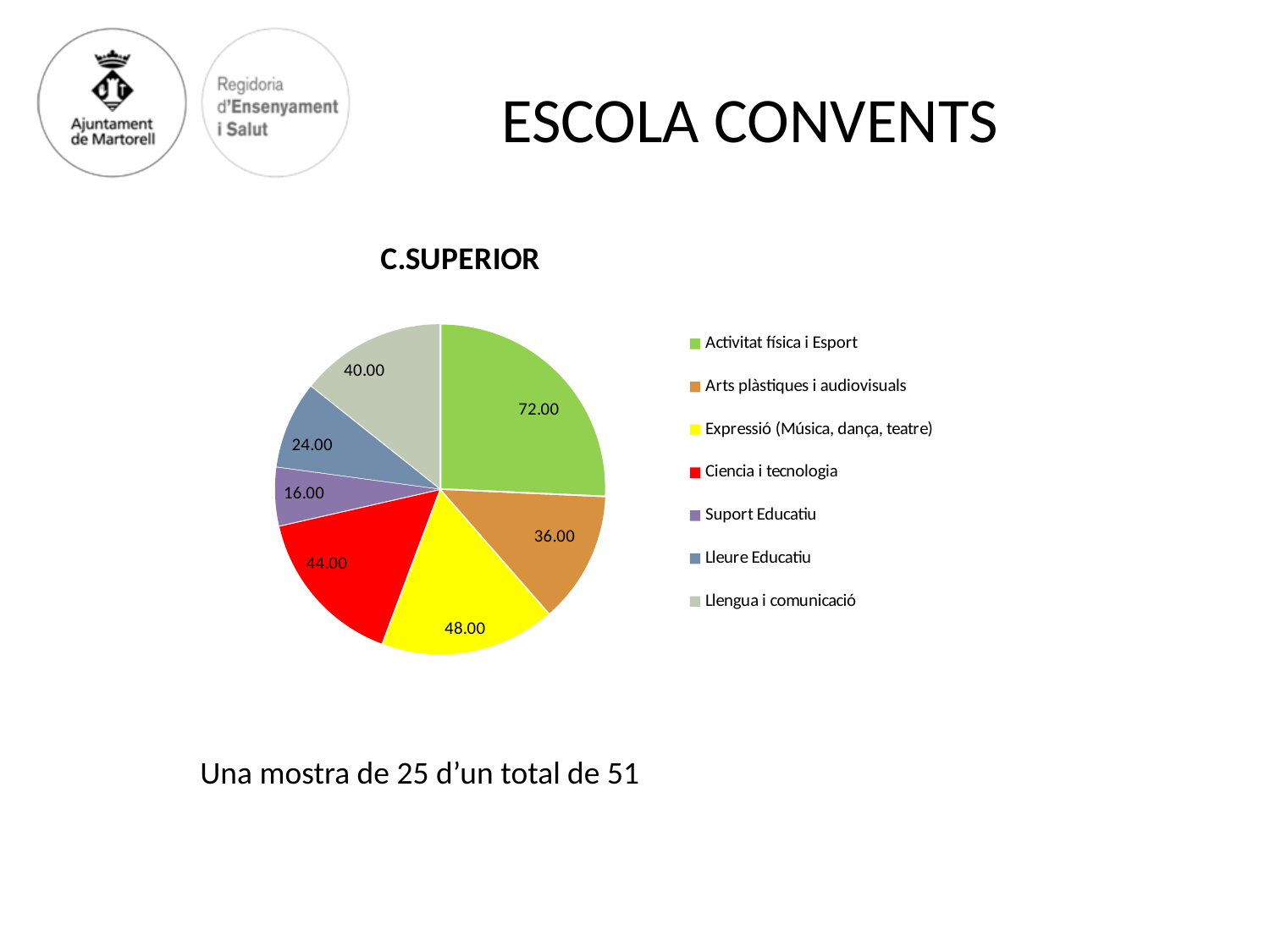
What is the difference between the values for Expressió (Música, dança, teatre) and Arts plàstiques i audiovisuals? 12.00 Which is larger, the value for Lleure Educatiu or the value for Llengua i comunicació? Llengua i comunicació What is the value for Suport Educatiu? 16.00 What is the value for Ciencia i tecnologia? 44.00 What is the title of the chart? C.SUPERIOR Which category has the largest slice of the pie? Activitat física i Esport Which category has the smallest slice of the pie? Suport Educatiu What colour is the slice for Ciencia i tecnologia? red What type of chart is shown on the slide? pie chart How many categories does the legend list? 7 What is the value for Activitat física i Esport? 72.00 What is the value for Llengua i comunicació? 40.00